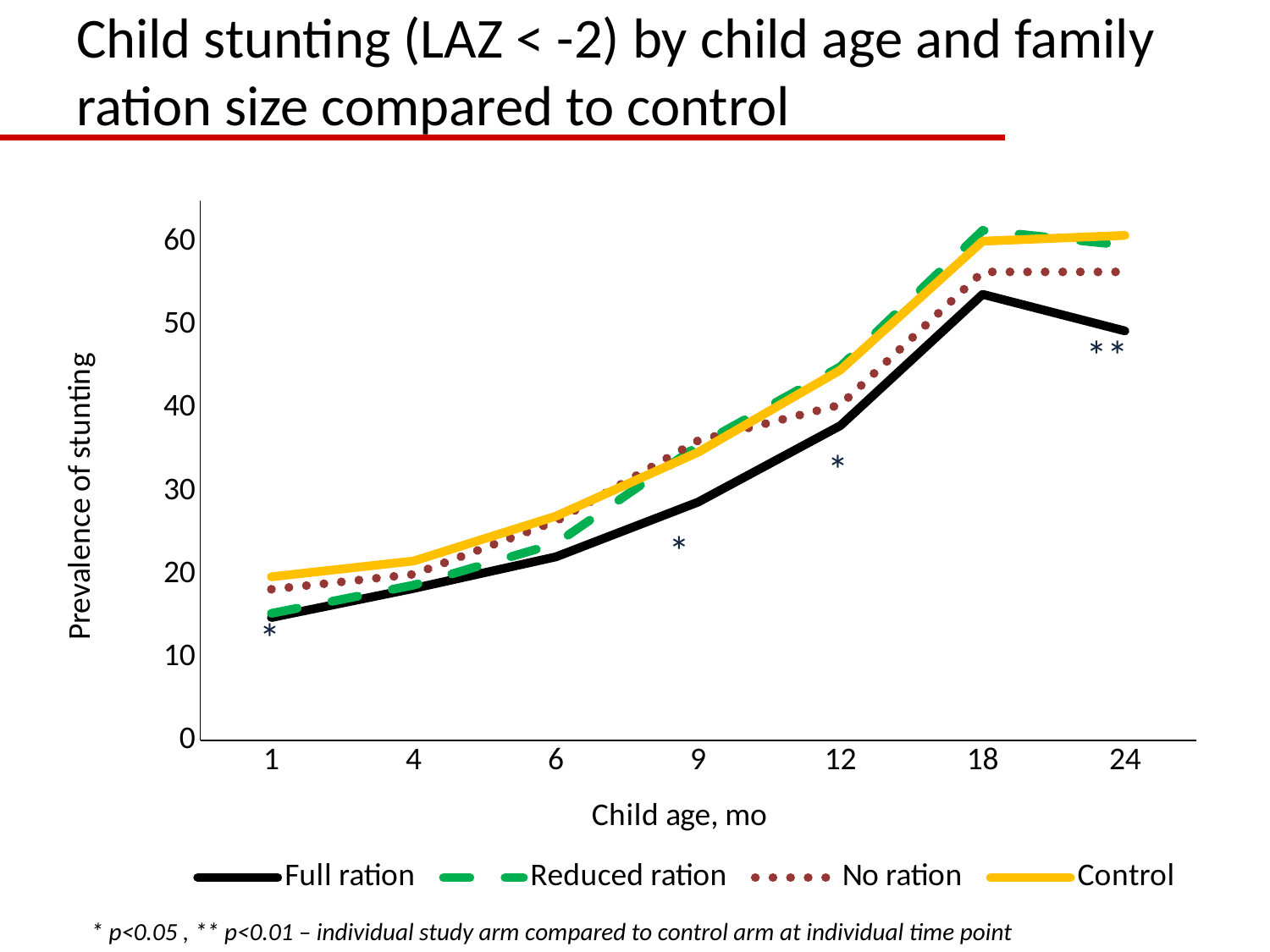
What kind of chart is shown on the slide? line chart Which series has the lowest value at 12 months? Full ration Is the value for Control at 12 months greater or less than 40? greater How many series does the legend list? 4 Is the value for No ration at 24 months greater or less than 60? less What is the label of the y axis? Prevalence of stunting Does the Control line generally rise or fall as child age increases from 1 to 18 months? rise Is the value for Full ration at 12 months greater or less than 40? less At 24 months, which is larger: Control or Full ration? Control How many child age points are plotted along the x axis? 7